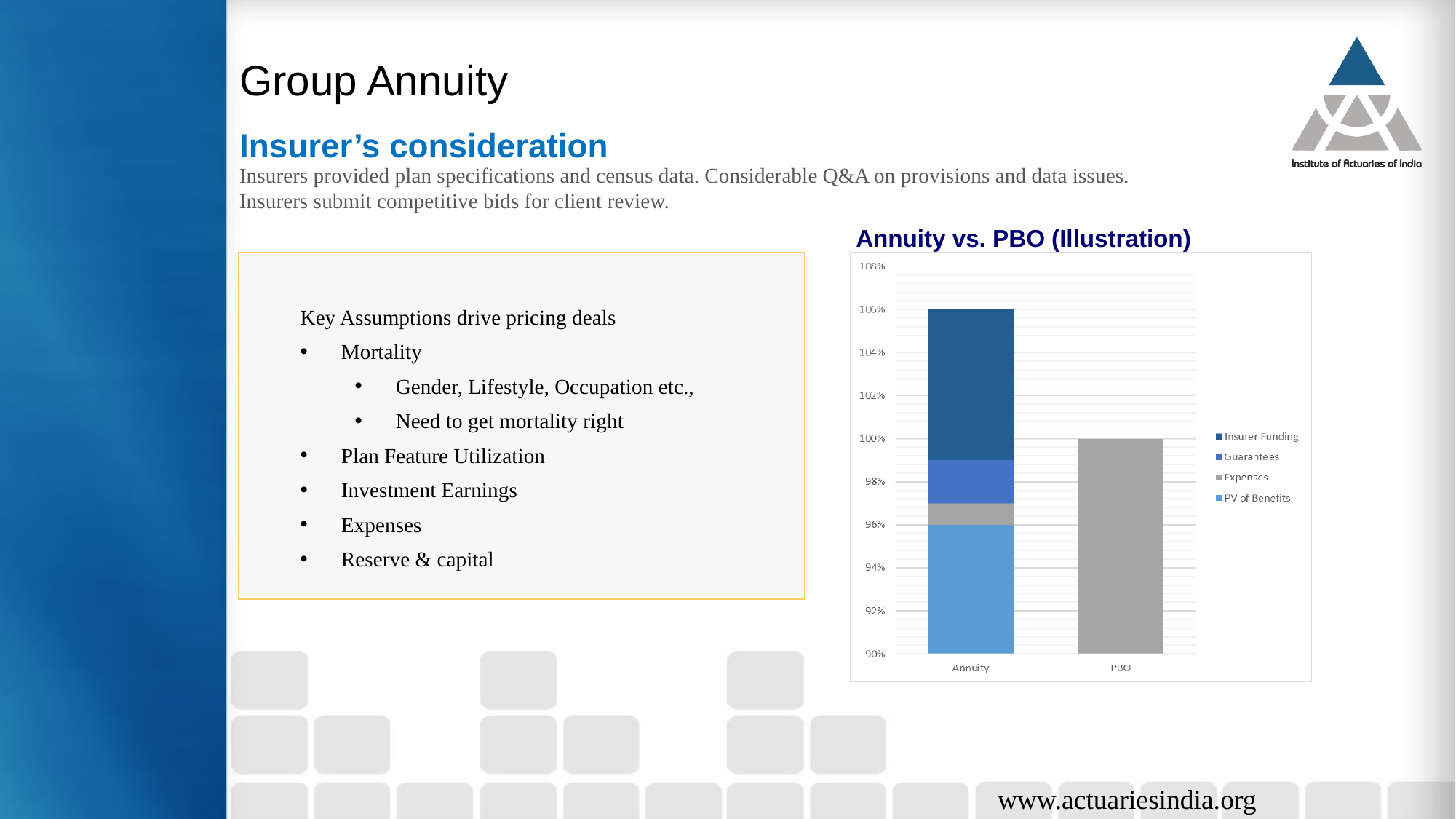
What is the total height of the PBO bar in the 'Annuity vs. PBO (Illustration)' chart? 100% Is the top of the PV of Benefits segment in the Annuity bar greater or less than 98%? less Which category has the lowest total bar in the 'Annuity vs. PBO (Illustration)' chart? PBO How many categories are shown on the x axis of the 'Annuity vs. PBO (Illustration)' chart? 2 Which category has the taller bar in the 'Annuity vs. PBO (Illustration)' chart, Annuity or PBO? Annuity How many series does the legend of the 'Annuity vs. PBO (Illustration)' chart list? 4 Is the total for the Annuity bar in the 'Annuity vs. PBO (Illustration)' chart greater or less than 104%? greater Which series is listed first in the legend of the 'Annuity vs. PBO (Illustration)' chart? Insurer Funding Which series forms the bottom segment of the Annuity bar in the 'Annuity vs. PBO (Illustration)' chart? PV of Benefits What is the total height of the Annuity stacked bar in the 'Annuity vs. PBO (Illustration)' chart? 106% What kind of chart is shown under the title 'Annuity vs. PBO (Illustration)'? stacked bar chart What is the highest value shown on the y axis of the 'Annuity vs. PBO (Illustration)' chart? 108%